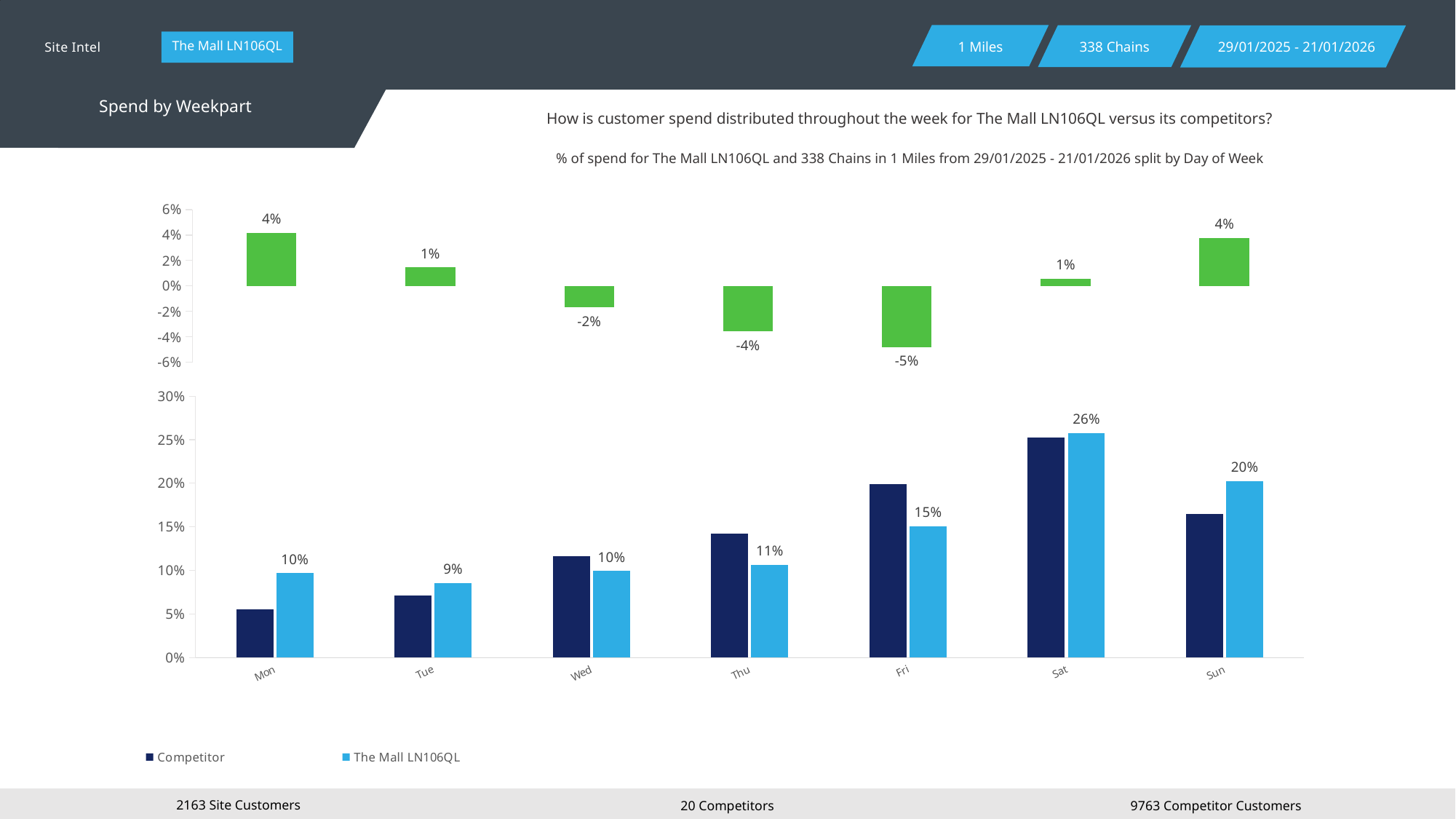
How many series does the legend of the bottom chart list? 2 How many days of the week are shown on the x axis of the bottom chart? 7 In the bottom chart, what is the difference between The Mall LN106QL values for Sat and Sun? 6 percentage points In the bottom chart, is the Competitor value for Mon greater or less than 10%? less In the bottom chart, on which day is the value for The Mall LN106QL highest? Sat In the top chart, which day has the lowest value? Fri In the bottom chart, what is the value for The Mall LN106QL on Sat? 26% In the top chart, what is the value for Fri? -5% In the bottom chart, on which day is the value for The Mall LN106QL lowest? Tue In the top chart, what is the value for Wed? -2% In the bottom chart, what is the value for The Mall LN106QL on Fri? 15% In the bottom chart, on Fri, which is larger: Competitor or The Mall LN106QL? Competitor